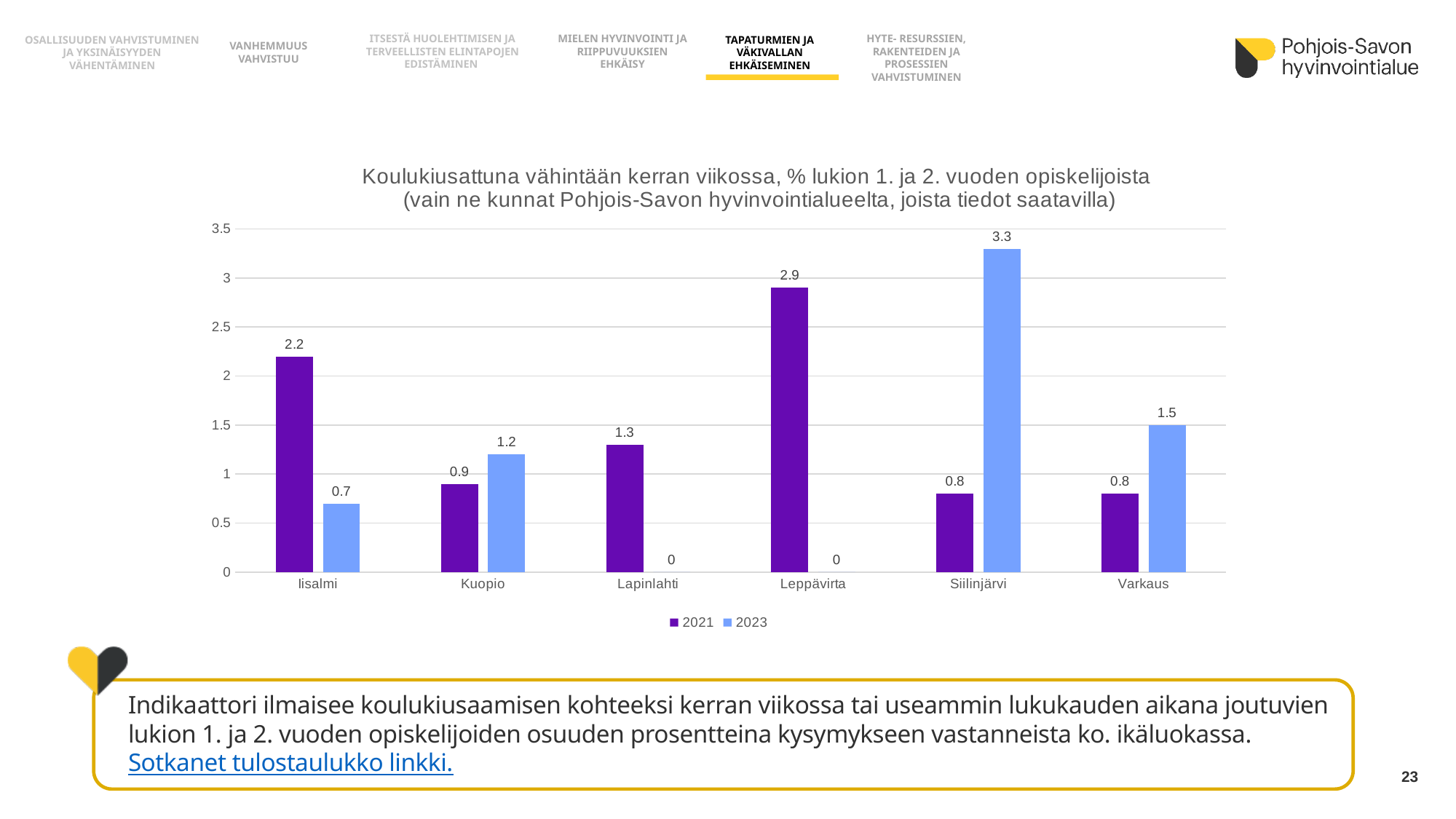
What is the difference between the 2023 and 2021 values for Siilinjärvi? 2.5 What is the 2023 value for Siilinjärvi? 3.3 How many series does the legend list? 2 What is the 2021 value for Leppävirta? 2.9 What kind of chart is shown on the slide? Bar chart Which series is shown in purple in the legend? 2021 Which municipality has the highest 2021 value? Leppävirta What is the 2023 value for Iisalmi? 0.7 Which municipality has the highest 2023 value? Siilinjärvi Which is larger for Kuopio, the 2021 value or the 2023 value? 2023 How many municipalities are shown on the x axis? 6 Which municipality has the lowest 2021 value? Siilinjärvi and Varkaus (0.8)